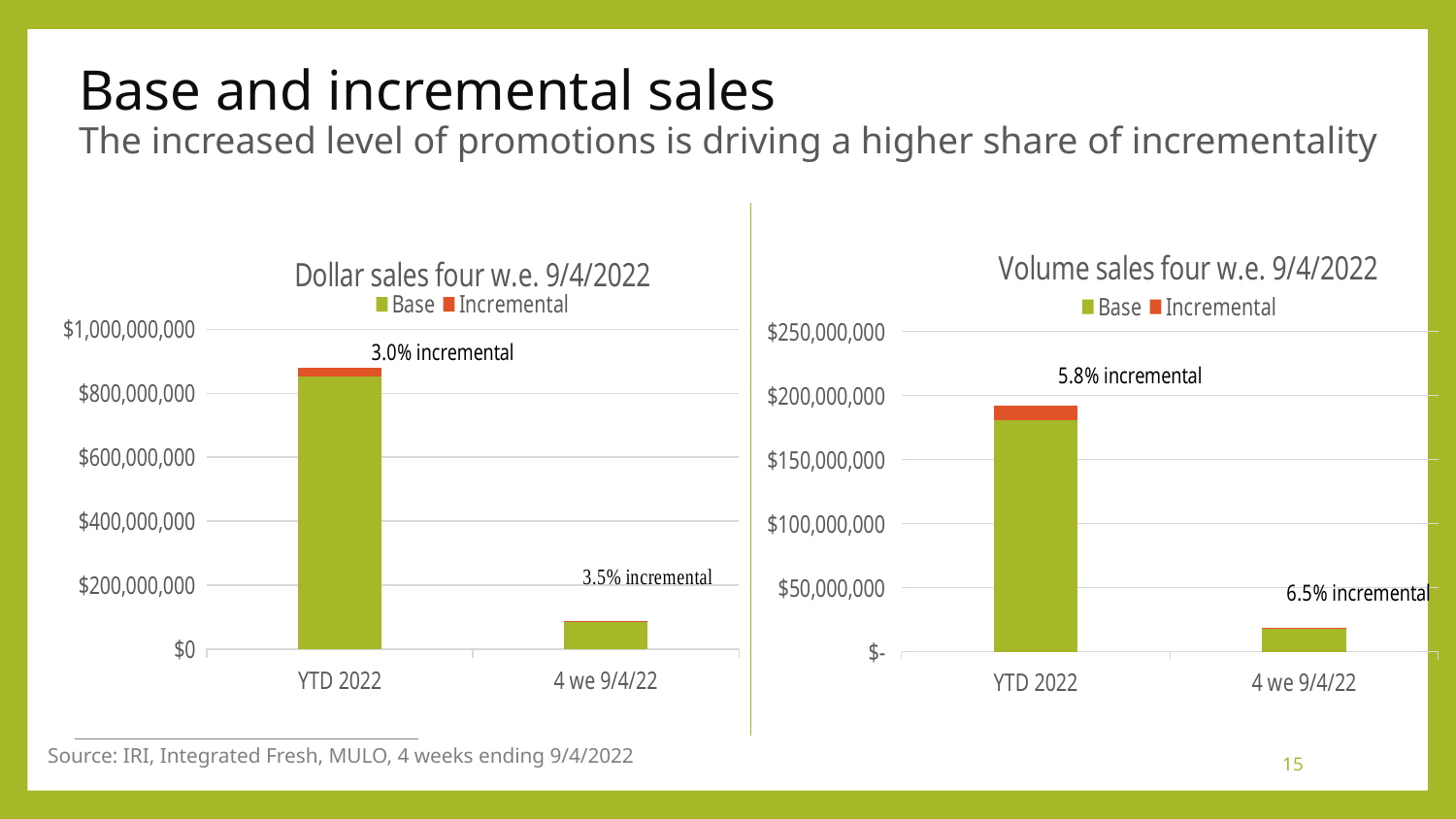
In the Dollar sales four w.e. 9/4/2022 chart, what incremental percentage is annotated for 4 we 9/4/22? 3.5% incremental In the Volume sales four w.e. 9/4/2022 chart, is the total value for 4 we 9/4/22 greater or less than $50,000,000? less In the Dollar sales four w.e. 9/4/2022 chart, is the total value for 4 we 9/4/22 greater or less than $200,000,000? less In the Volume sales four w.e. 9/4/2022 chart, is the total value for YTD 2022 greater or less than $150,000,000? greater In the Volume sales four w.e. 9/4/2022 chart, what incremental percentage is annotated for YTD 2022? 5.8% incremental In the Volume sales four w.e. 9/4/2022 chart, which category has the shorter bar? 4 we 9/4/22 How many series does the legend of the Volume sales four w.e. 9/4/2022 chart list? 2 In the Dollar sales four w.e. 9/4/2022 chart, which category has the taller bar? YTD 2022 What kind of chart is the Dollar sales four w.e. 9/4/2022 chart? Stacked bar chart In the Volume sales four w.e. 9/4/2022 chart, what incremental percentage is annotated for 4 we 9/4/22? 6.5% incremental In the Dollar sales four w.e. 9/4/2022 chart, what incremental percentage is annotated for YTD 2022? 3.0% incremental